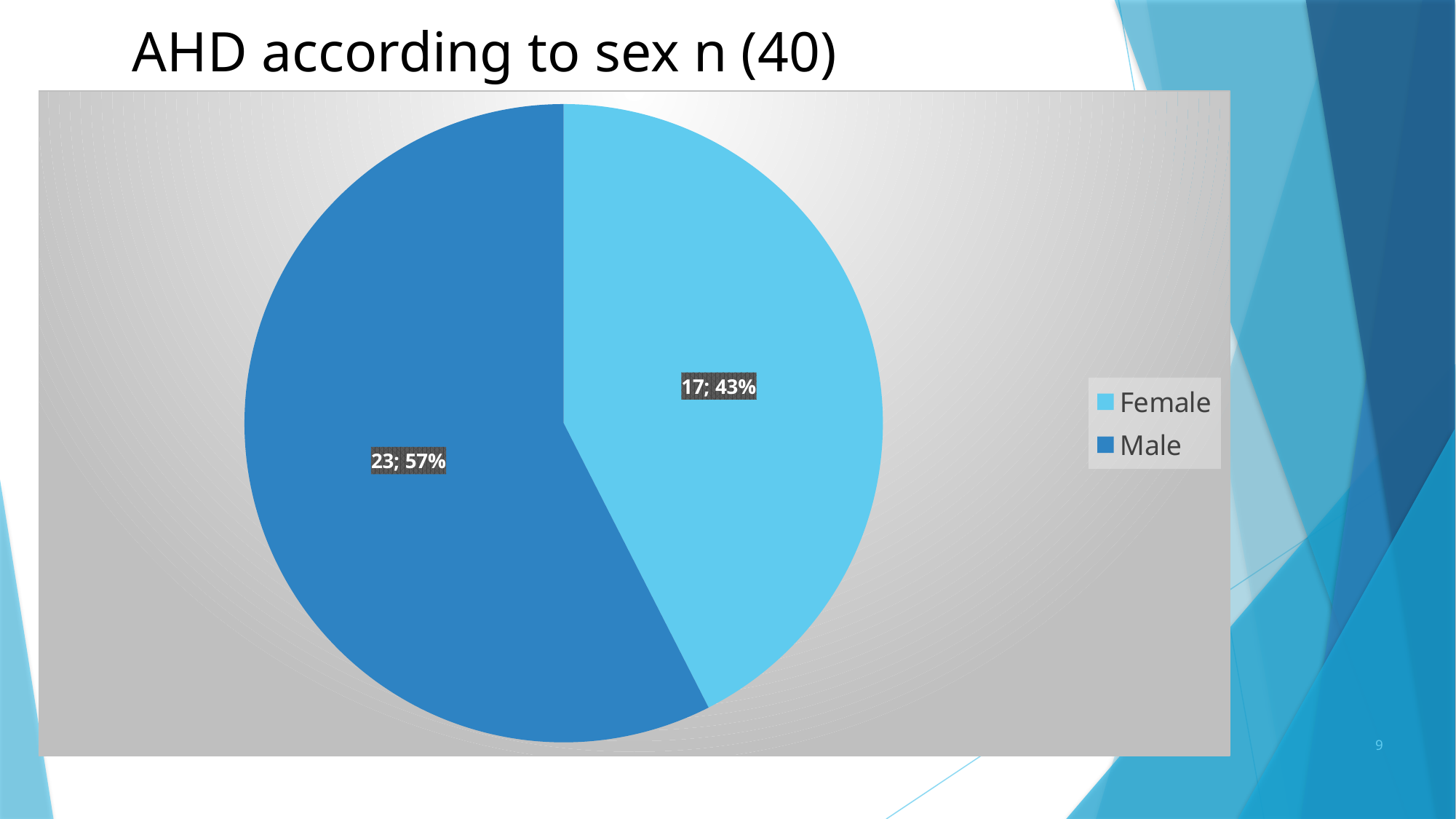
Which category has the largest slice of the pie? Male What is the title of the slide containing the chart? AHD according to sex n (40) How many slices does the pie chart have? 2 What percentage of the pie does the Male slice represent? 57% How many patients are Female according to the pie chart? 17 How many patients are Male according to the pie chart? 23 How many entries does the legend list? 2 Which category has the smallest slice of the pie? Female What type of chart is shown on the slide? pie chart What is the difference between the Male count and the Female count? 6 Which is larger, the Male count or the Female count? Male What percentage of the pie does the Female slice represent? 43%